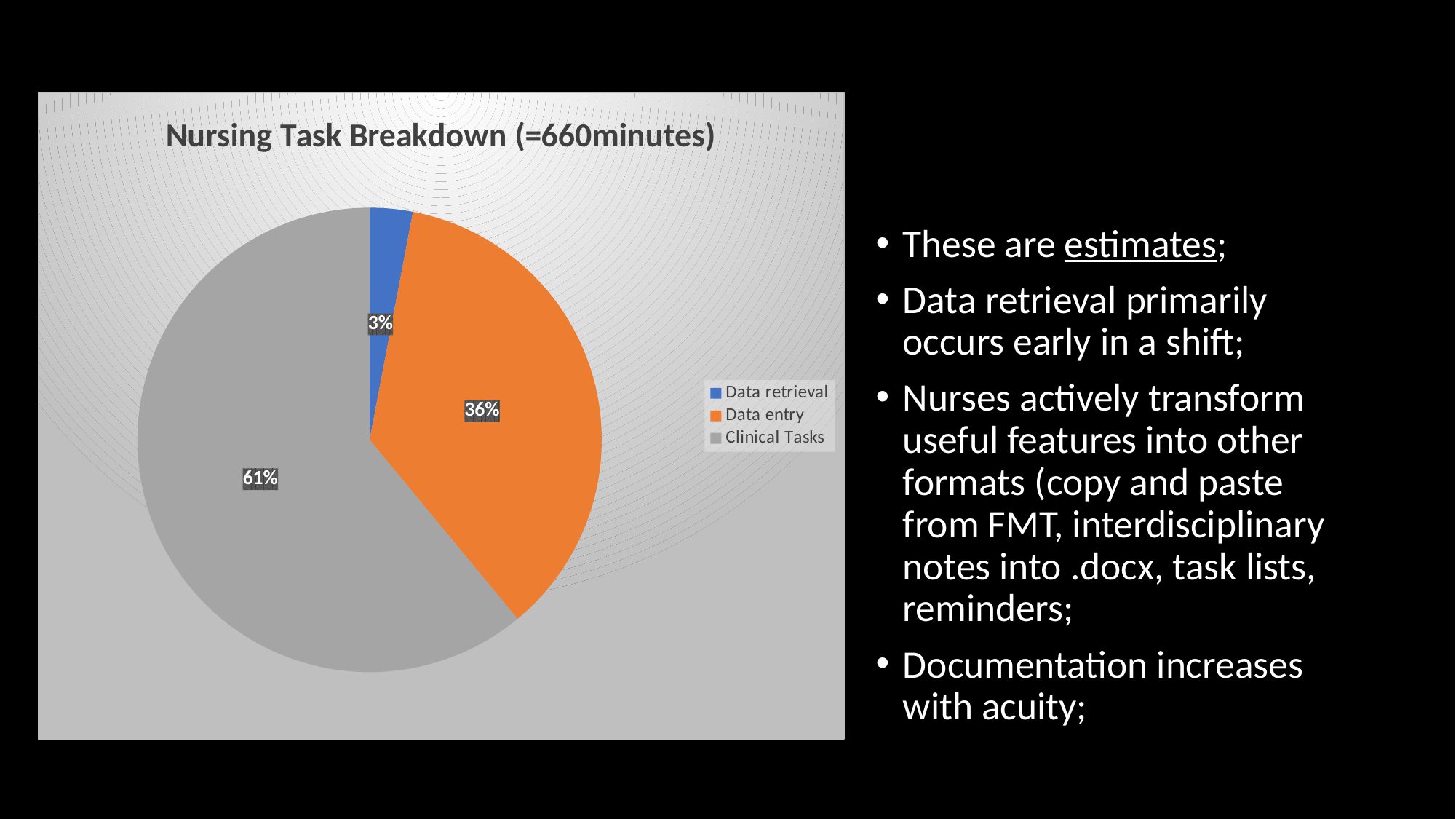
Which category has the smallest slice of the pie? Data retrieval What kind of chart is shown on the slide? pie chart Which category has the largest slice of the pie? Clinical Tasks What colour is the Data entry slice? orange What is the difference in percentage points between the Clinical Tasks share and the Data entry share? 25 What share of the pie does Data retrieval take? 3% What is the title of the chart? Nursing Task Breakdown (=660minutes) Which is larger, the share for Data entry or the share for Data retrieval? Data entry How many categories does the pie chart show? 3 What share of the pie does Clinical Tasks take? 61% How many entries does the legend list? 3 What share of the pie does Data entry take? 36%